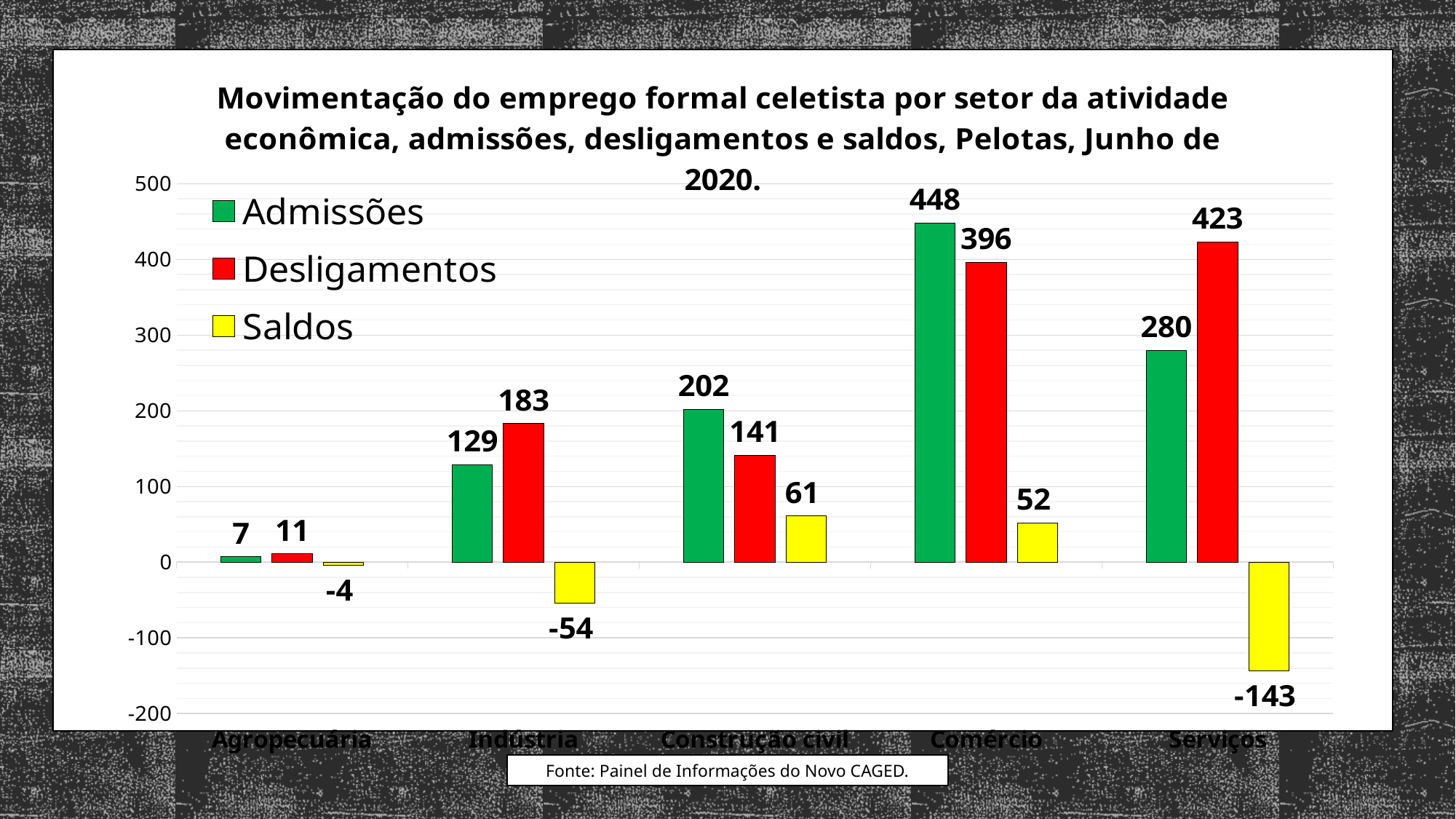
What kind of chart is shown on the slide? Bar chart What is the Saldos value for Indústria? -54 How many series does the legend list? 3 How many sectors are shown on the x axis? 5 What is the Desligamentos value for Serviços? 423 Which is larger for Indústria, Admissões or Desligamentos? Desligamentos What is the Saldos value for Agropecuária? -4 What is the difference between Admissões and Desligamentos for Construção civil? 61 Which sector has the highest Admissões value? Comércio What is the Admissões value for Comércio? 448 Which sector has the lowest Saldos value? Serviços What colour represents the Saldos series? Yellow